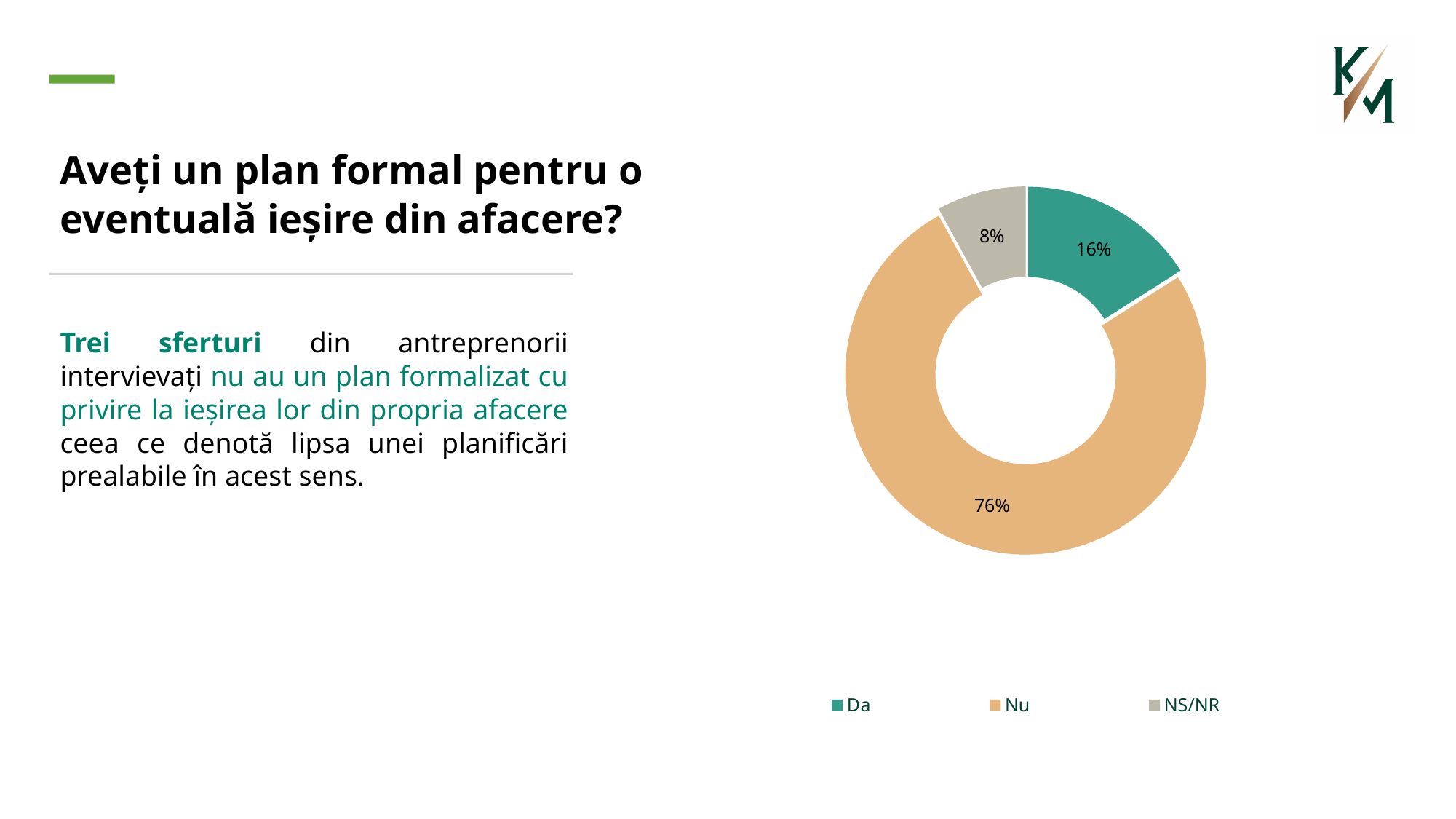
How many categories are shown in the chart? 3 What is the difference in percentage points between "Da" and "NS/NR"? 8 What kind of chart is shown on the slide? Doughnut chart What are the three legend entries of the chart? Da, Nu, NS/NR What percentage of respondents answered "Nu"? 76% What percentage of respondents answered "Da"? 16% What colour is the "Nu" segment of the chart? Orange What is the difference in percentage points between "Nu" and "Da"? 60 What percentage of respondents answered "NS/NR"? 8% Which category has the largest share of the chart? Nu Which is larger, the share for "Da" or the share for "NS/NR"? Da Which category has the smallest share of the chart? NS/NR